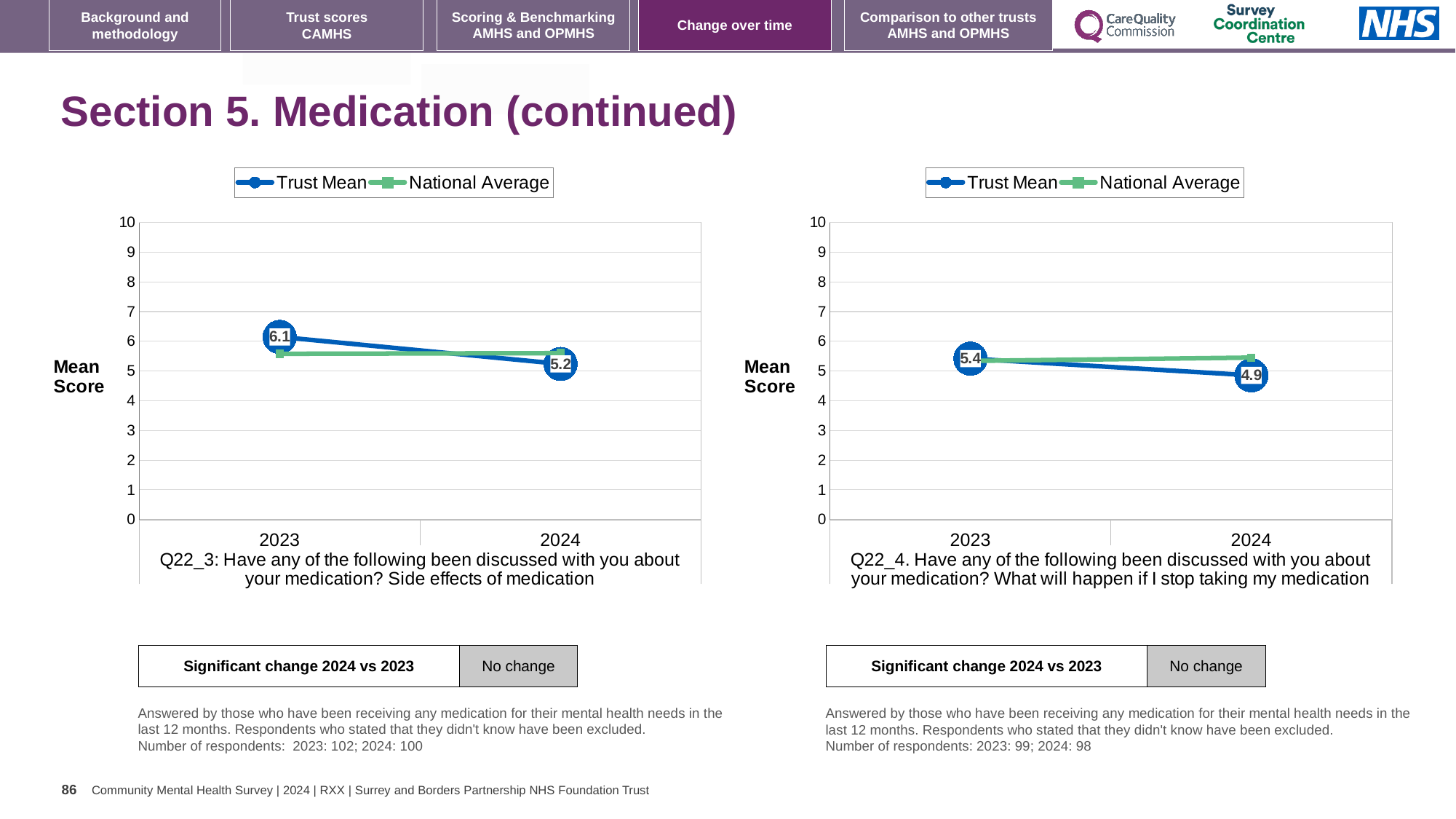
In the right chart (Q22_4), what is the Trust Mean for 2023? 5.4 In the left chart (Q22_3), is the National Average for 2024 greater or less than 5? greater In the right chart (Q22_4), what is the difference between the Trust Mean in 2023 and 2024? 0.5 What kind of chart is the left chart (Q22_3)? line chart In the left chart (Q22_3), what is the Trust Mean for 2024? 5.2 How many series does the legend of the right chart (Q22_4) list? 2 In the left chart (Q22_3), what is the Trust Mean for 2023? 6.1 In the right chart (Q22_4), what is the Trust Mean for 2024? 4.9 In the right chart (Q22_4), which is larger in 2024, the Trust Mean or the National Average? National Average In the right chart (Q22_4), does the Trust Mean rise or fall from 2023 to 2024? fall In the left chart (Q22_3), by how much did the Trust Mean change from 2023 to 2024? 0.9 In the left chart (Q22_3), does the Trust Mean rise or fall from 2023 to 2024? fall